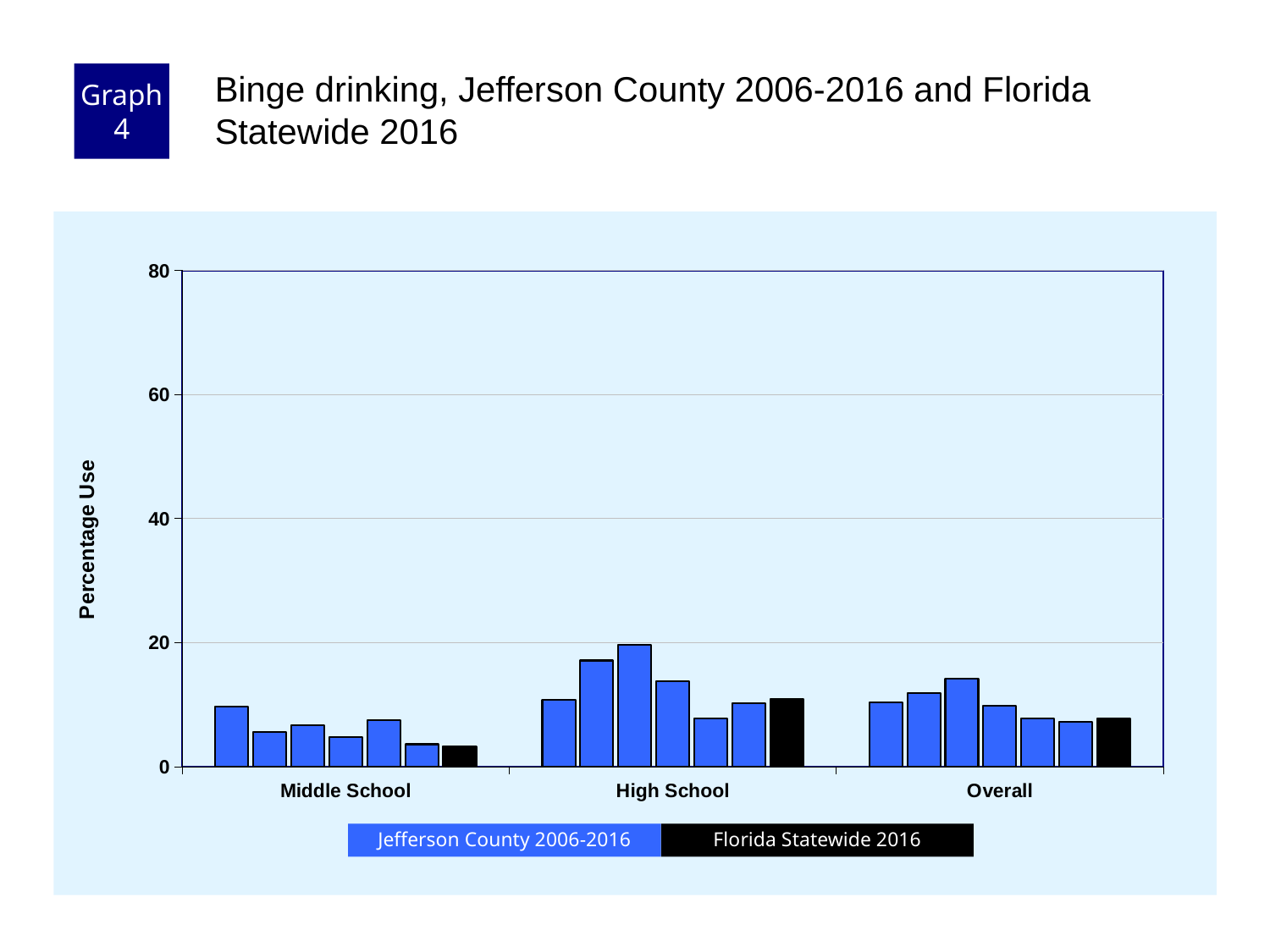
Which category has the lowest Florida Statewide 2016 bar? Middle School Which category has the tallest bar in the chart? High School What is the title of the chart on the slide? Binge drinking, Jefferson County 2006-2016 and Florida Statewide 2016 What kind of chart is shown on the slide? bar chart How many categories are shown on the x axis of the chart? 3 Is the Florida Statewide 2016 value for Middle School greater or less than 20? less How many series does the chart's legend list? 2 Is the Florida Statewide 2016 value for Overall greater or less than 40? less Is the Florida Statewide 2016 value for High School greater or less than 20? less Is the Florida Statewide 2016 bar larger for High School or for Middle School? High School What is the label on the vertical axis of the chart? Percentage Use